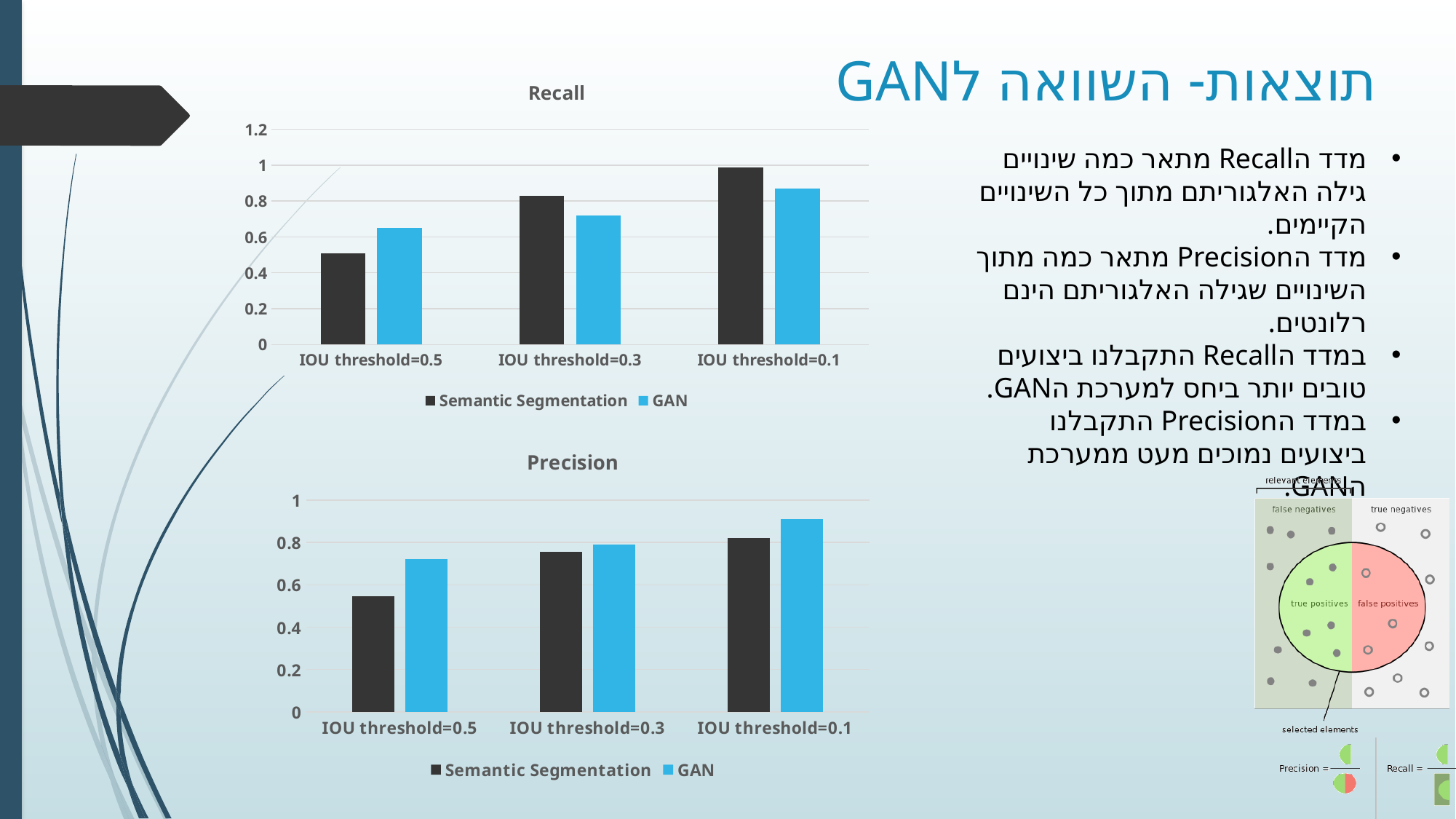
In the Recall chart, do the Semantic Segmentation values rise or fall from IOU threshold=0.5 to IOU threshold=0.1? rise In the Precision chart, at IOU threshold=0.5, which is larger: Semantic Segmentation or GAN? GAN In the Recall chart, which series has the highest bar overall? Semantic Segmentation How many IOU threshold categories are shown on the Recall chart? 3 What kind of chart is the Recall chart? bar chart In the Recall chart, is the Semantic Segmentation value at IOU threshold=0.1 greater or less than 0.8? greater In the Precision chart, which category has the highest GAN bar? IOU threshold=0.1 In the Recall chart, is the GAN value at IOU threshold=0.3 greater or less than 0.8? less In the Recall chart, which category has the lowest Semantic Segmentation bar? IOU threshold=0.5 In the Precision chart, is the GAN value at IOU threshold=0.1 greater or less than 0.8? greater In the Recall chart, at IOU threshold=0.5, which is larger: Semantic Segmentation or GAN? GAN How many series does the legend of the Precision chart list? 2